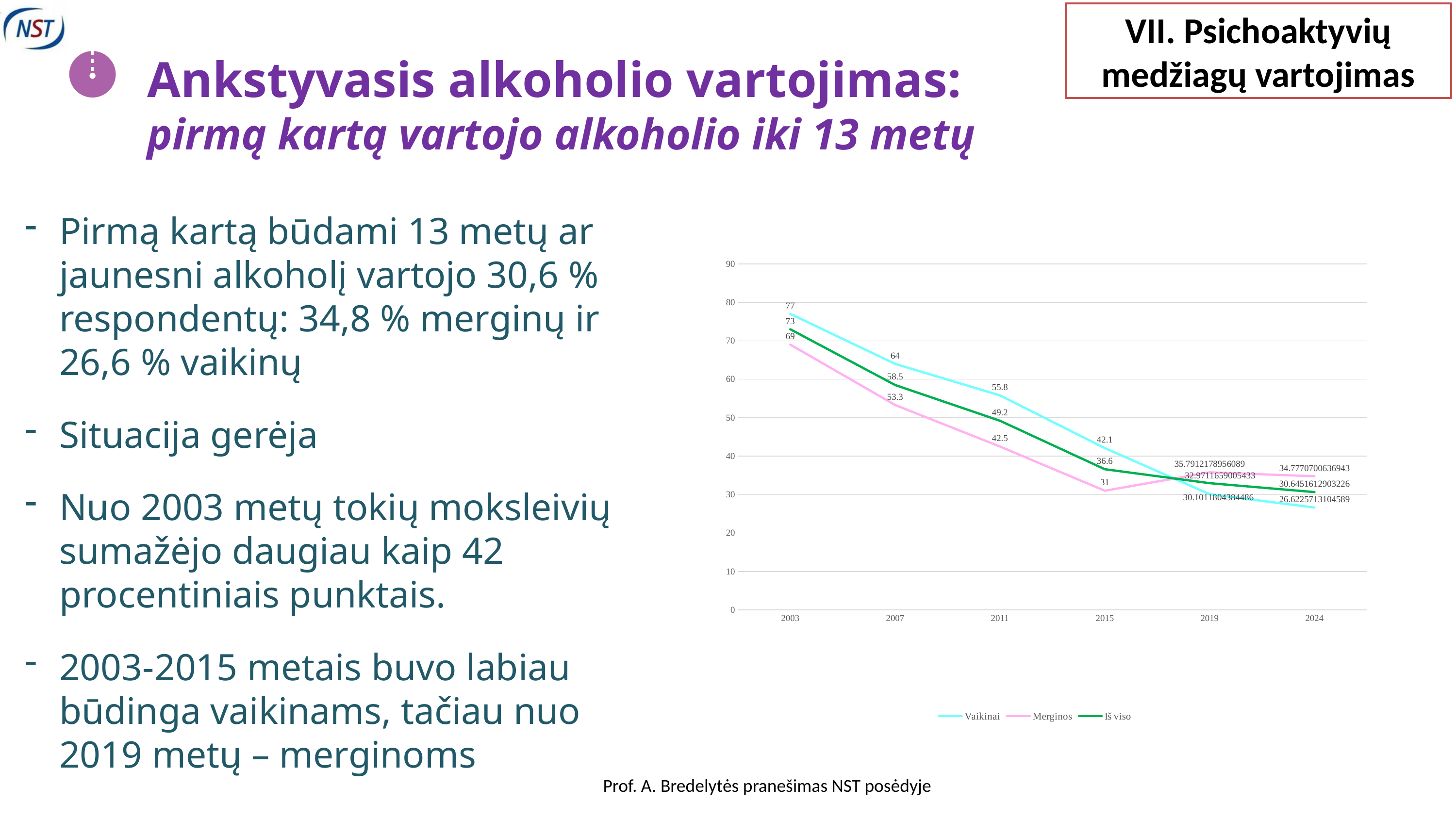
What is the value for Iš viso in 2011? 49.2 In which year is the Vaikinai series at its lowest? 2024 What is the value for Merginos in 2007? 53.3 In which year is the Vaikinai series at its highest? 2003 What is the value for Vaikinai in 2003? 77 How many series does the chart legend list? 3 How many years are shown on the x axis of the chart? 6 What is the difference between the Vaikinai and Merginos values in 2003? 8 What is the value for Merginos in 2015? 31 Does the Iš viso series rise or fall from 2003 to 2024? fall Which series has the larger value in 2024, Vaikinai or Merginos? Merginos What kind of chart is shown on the slide? line chart